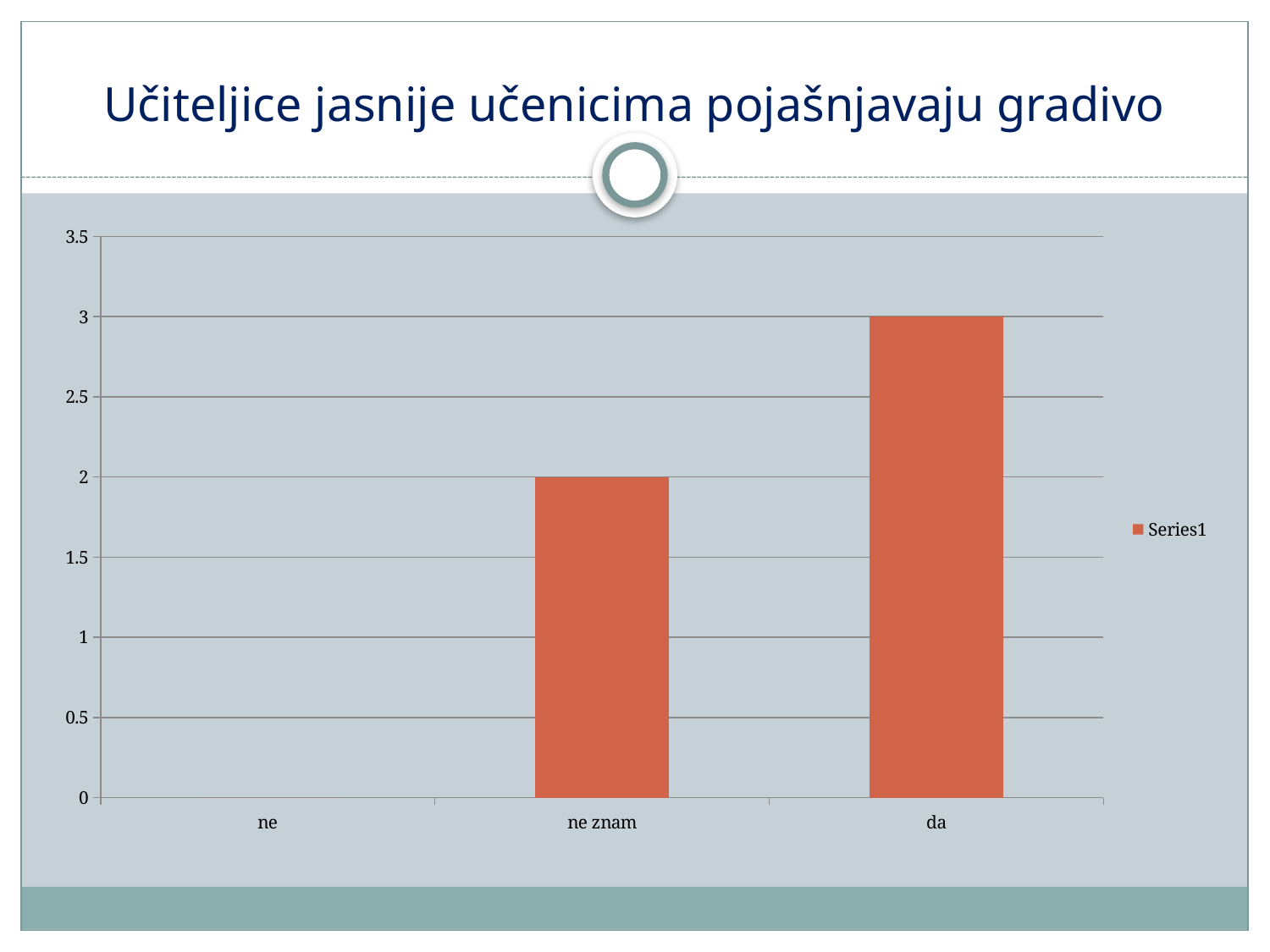
What is the difference between the values for "da" and "ne znam"? 1 Do the values rise or fall from left to right along the x axis? rise What is the name of the series shown in the legend? Series1 What is the value for "da"? 3 How many categories are shown on the x axis of the chart? 3 What is the value for "ne"? 0 Which category has the highest value? da Which category has the lowest value? ne How many series does the legend list? 1 What kind of chart is shown on the slide? bar chart What is the value for "ne znam"? 2 Which is larger, the value for "ne znam" or the value for "da"? da